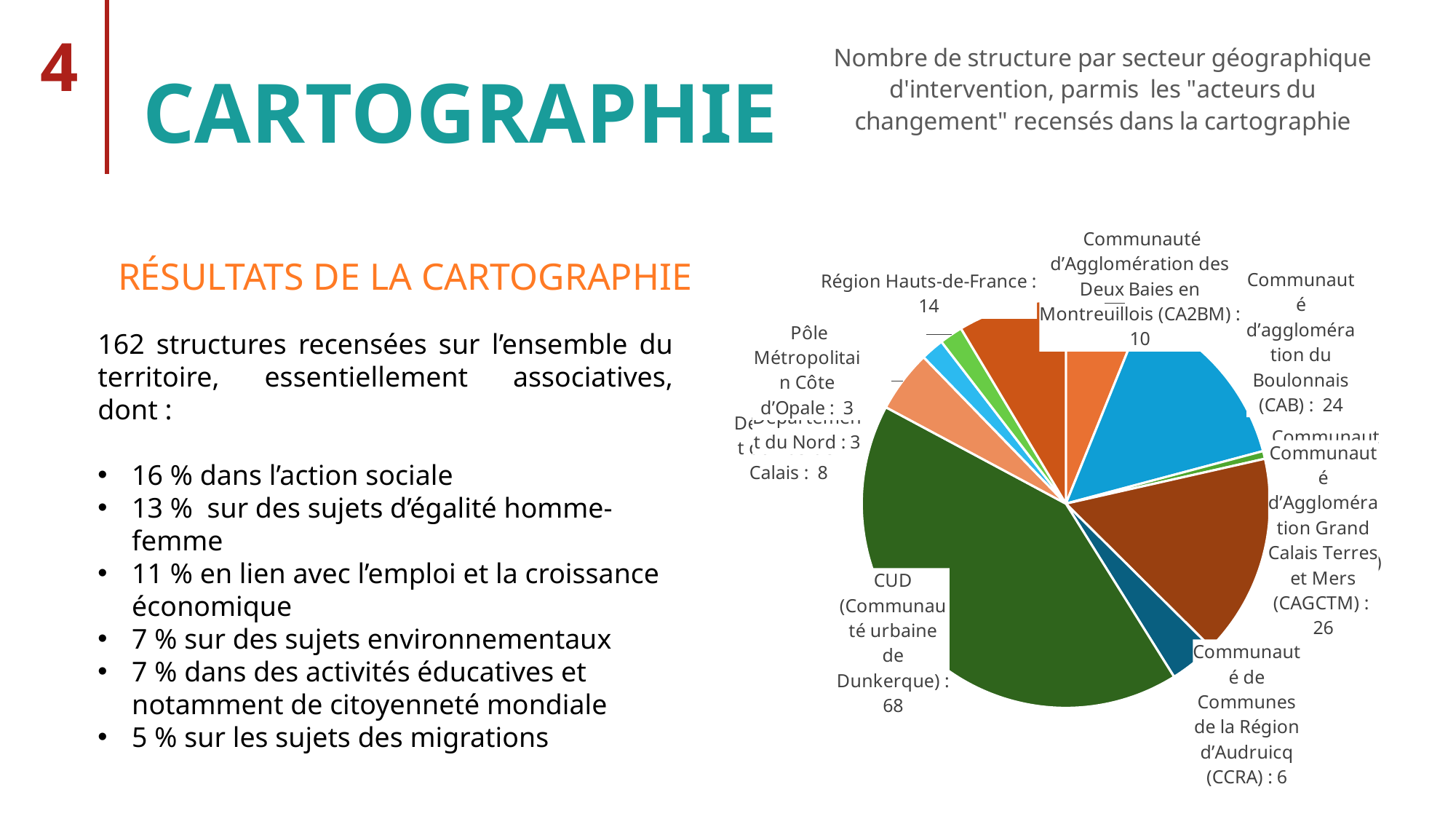
What is the value for Pôle Métropolitain Côte d'Opale? 3 How many structures are shown for CUD (Communauté urbaine de Dunkerque)? 68 What type of chart is shown on the slide? pie chart Which geographic sector has the largest slice of the pie? CUD (Communauté urbaine de Dunkerque) What is the value for Région Hauts-de-France? 14 What is the value for Communauté d'Agglomération Grand Calais Terres et Mers (CAGCTM)? 26 What is the value for Communauté d'Agglomération des Deux Baies en Montreuillois (CA2BM)? 10 What is the difference between the values for CAB and CA2BM? 14 Which has a larger value, CAB or CAGCTM? CAGCTM What is the value for Communauté de Communes de la Région d'Audruicq (CCRA)? 6 What is the difference between the values for CUD and CAGCTM? 42 What is the value for Communauté d'agglomération du Boulonnais (CAB)? 24